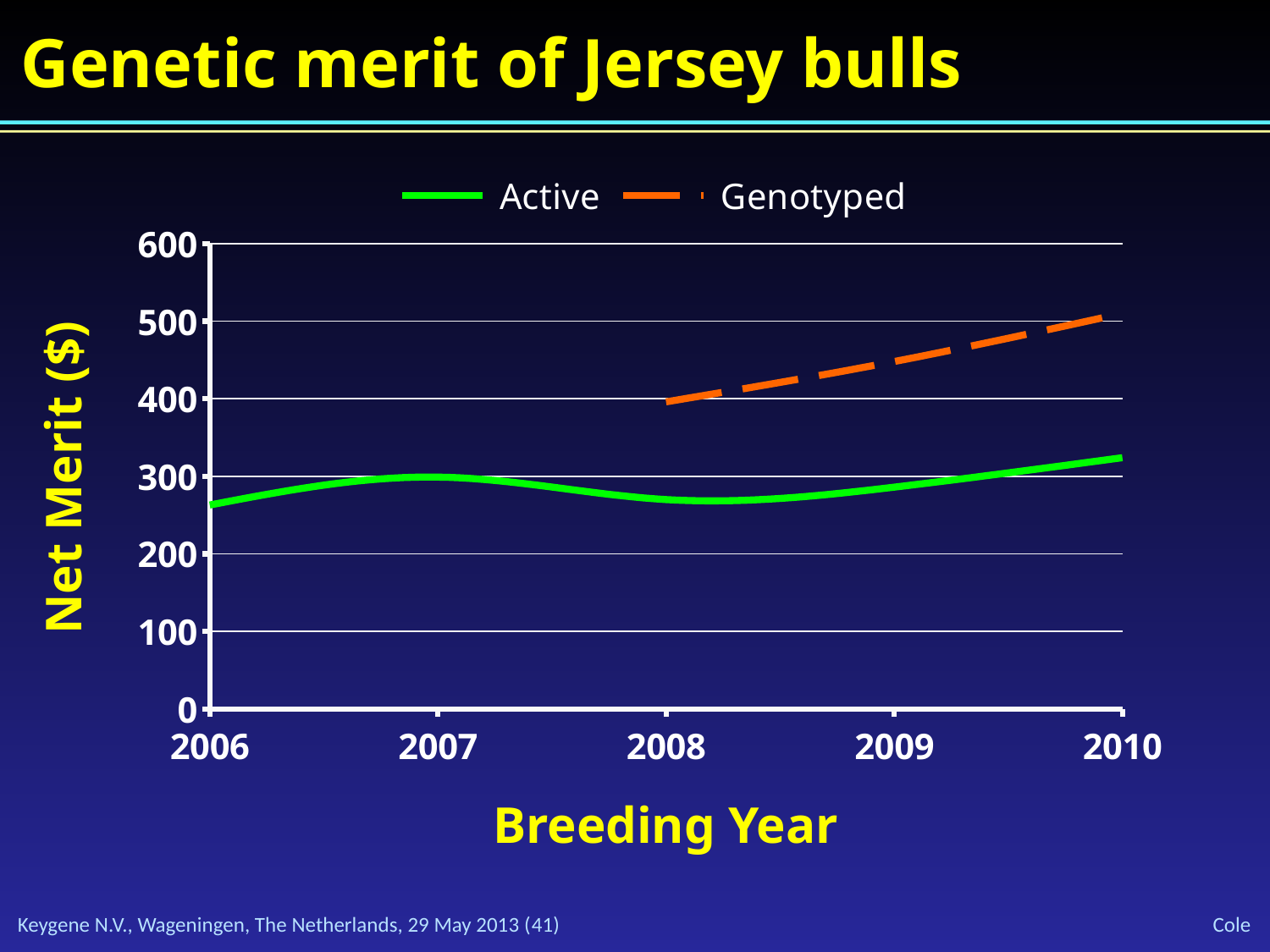
Is the Genotyped value for 2009 greater or less than 400? greater In 2010, which series has the higher Net Merit, Active or Genotyped? Genotyped What kind of chart is shown on the slide? line chart What is the label of the y axis? Net Merit ($) Is the Active value for 2010 greater or less than 300? greater Is the Active value for 2008 greater or less than 300? less How many series does the legend list? 2 Which series is drawn as a dashed line? Genotyped How many breeding years are labelled on the x axis? 5 Does the Genotyped line rise or fall from 2008 to 2010? rise